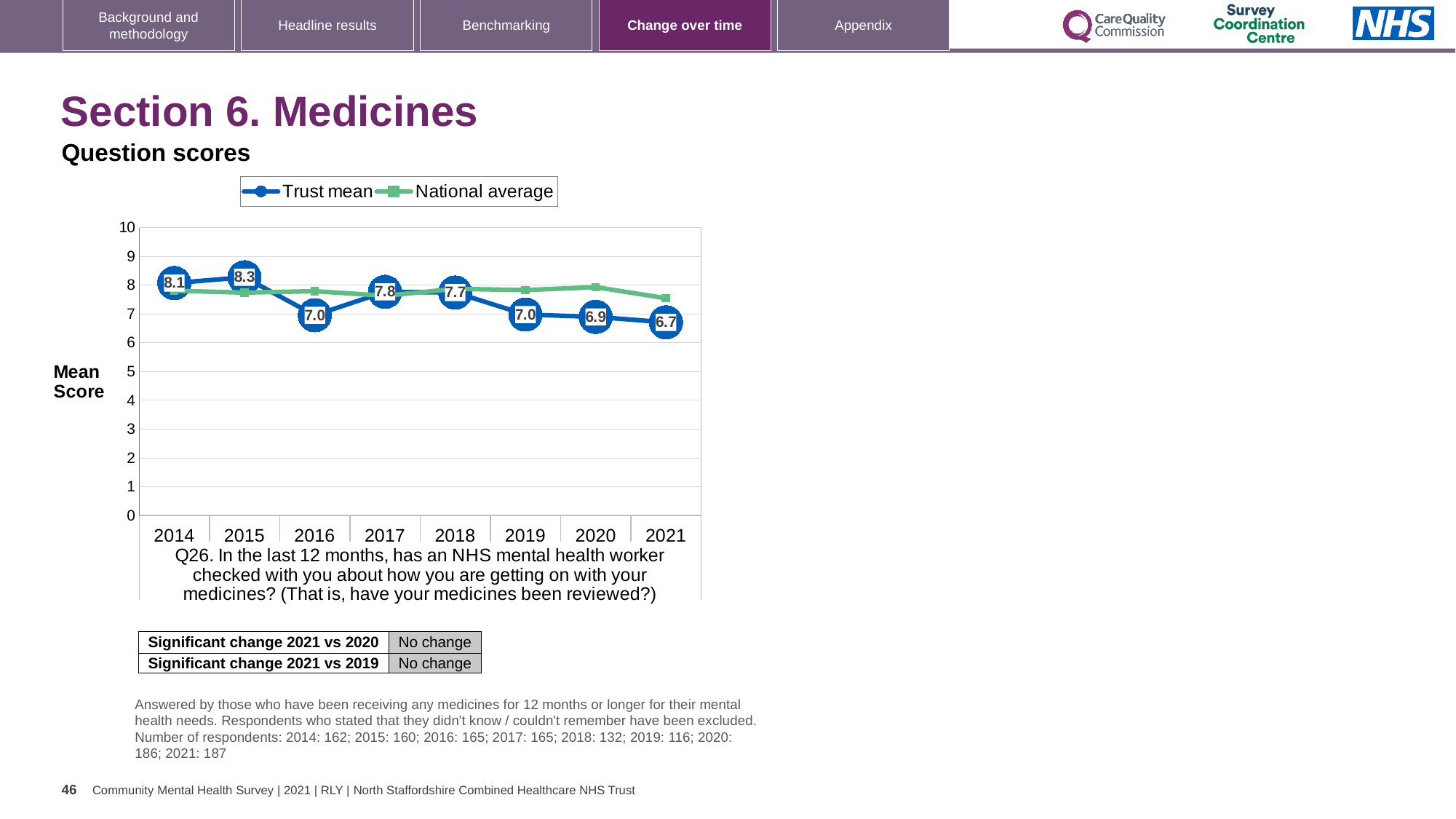
Is the National average value for 2020 greater or less than 7? greater Does the Trust mean score rise or fall from 2018 to 2021? fall In which year is the Trust mean score highest? 2015 What is the Trust mean score for 2018? 7.7 In which year is the Trust mean score lowest? 2021 What is the Trust mean score for 2021? 6.7 What kind of chart is shown on the slide? line chart How many years are shown on the x axis of the chart? 8 How many series does the chart legend list? 2 What is the difference between the Trust mean score in 2015 and in 2021? 1.6 What is the Trust mean score for 2015? 8.3 Which is larger, the Trust mean score in 2017 or in 2019? 2017